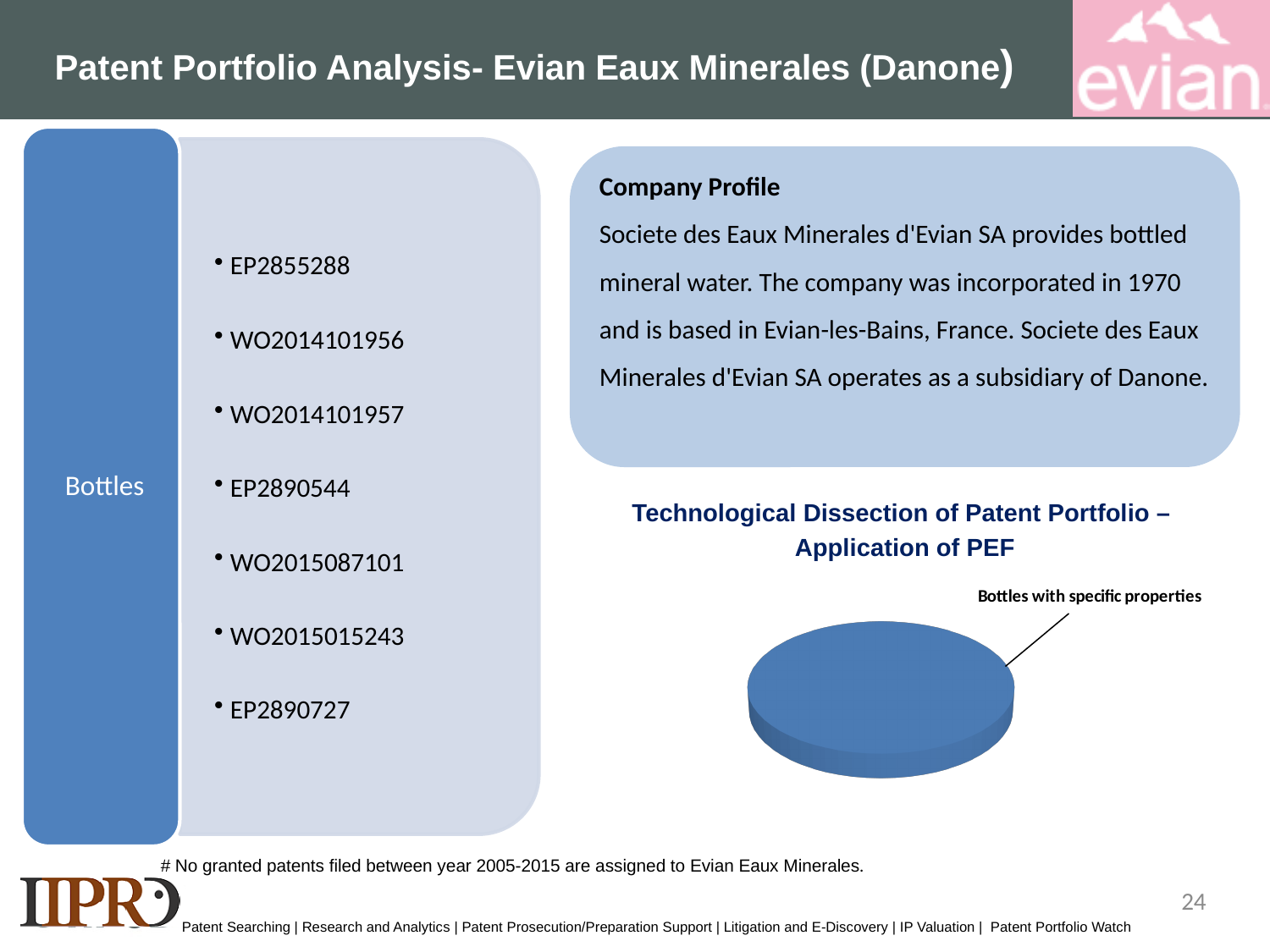
Which category accounts for the largest share of the pie chart? Bottles with specific properties What share of the pie chart does the slice "Bottles with specific properties" take up? 100% What is the label of the only slice in the pie chart? Bottles with specific properties What is the title of the chart on the slide? Technological Dissection of Patent Portfolio – Application of PEF What kind of chart is shown under the title "Technological Dissection of Patent Portfolio – Application of PEF"? Pie chart How many slices does the pie chart on the slide have? 1